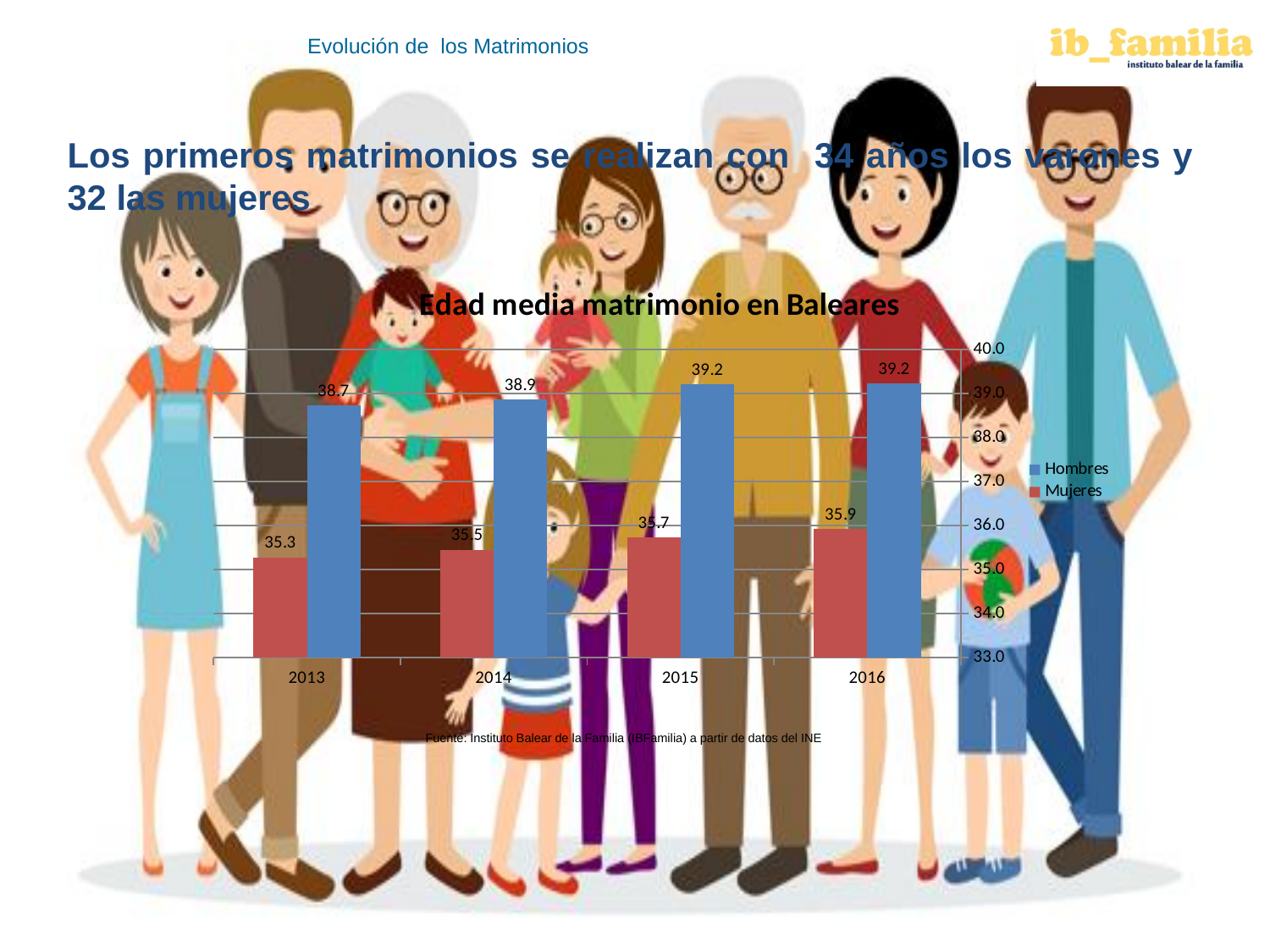
How many years are shown on the x axis of the chart? 4 What is the value for Hombres in 2013? 38.7 Do the Mujeres values rise or fall from 2013 to 2016? rise Which is larger in 2014, the value for Hombres or the value for Mujeres? Hombres What is the difference between the Hombres and Mujeres values in 2015? 3.5 Which colour represents the Hombres series in the chart? blue What type of chart is shown on the slide? bar chart What is the value for Mujeres in 2016? 35.9 How many series does the legend list? 2 What is the title of the chart? Edad media matrimonio en Baleares What is the value for Mujeres in 2014? 35.5 Which year has the lowest value for Mujeres? 2013